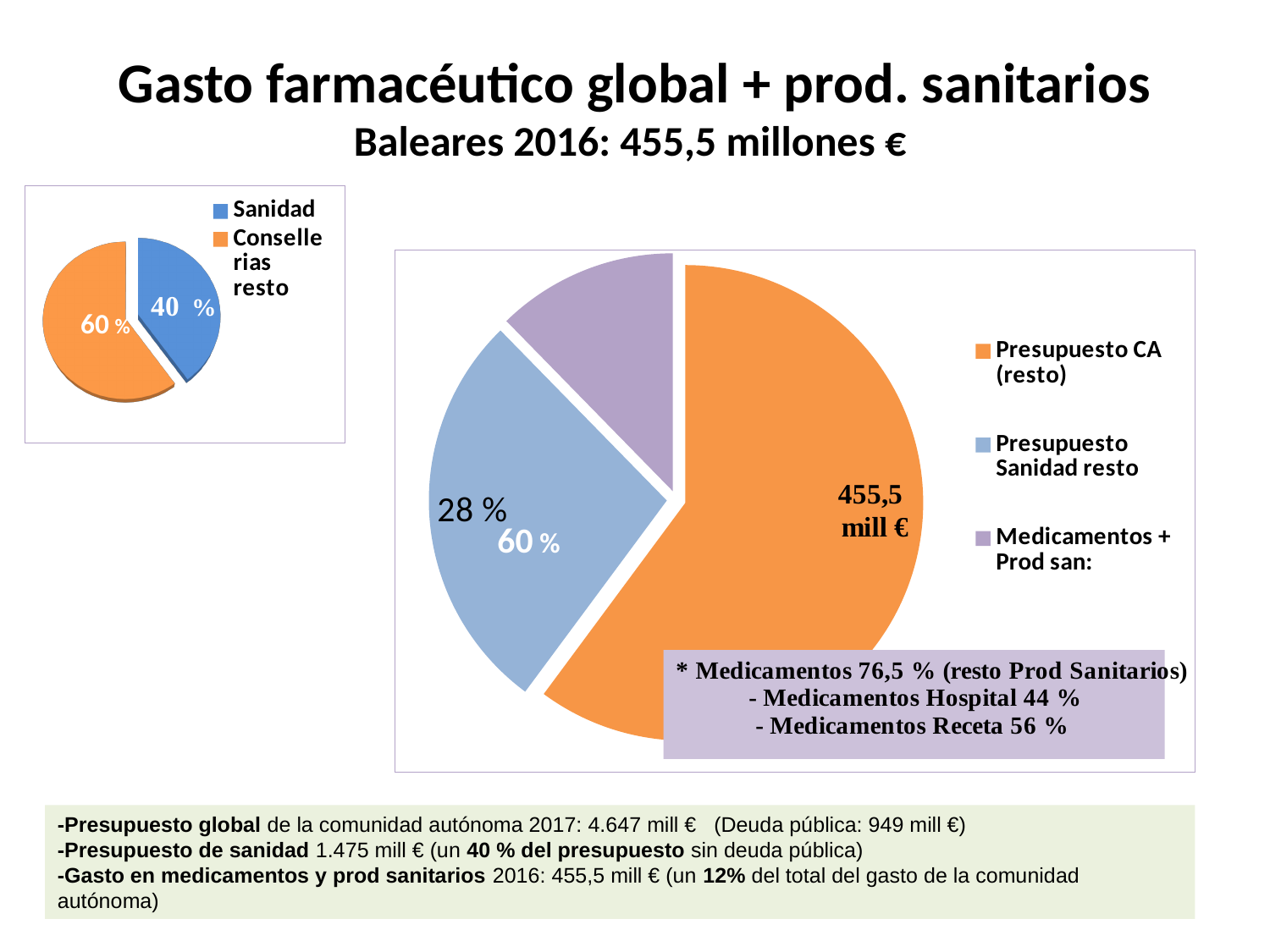
In the large pie chart on the right, what is the difference in percentage points between Presupuesto CA (resto) and Presupuesto Sanidad resto? 32 In the large pie chart on the right, what percentage is shown for Presupuesto Sanidad resto? 28 % In the small pie chart on the left, what percentage is shown for Consellerias resto? 60 % In the small pie chart on the left, what percentage is shown for Sanidad? 40 % In the large pie chart on the right, which colour represents Medicamentos + Prod san? Purple How many entries does the legend of the small pie chart on the left list? 2 In the large pie chart on the right, what percentage is shown for Presupuesto CA (resto)? 60 % In the large pie chart on the right, which category has the smallest slice? Medicamentos + Prod san In the large pie chart on the right, which category has the largest slice? Presupuesto CA (resto) What kind of chart is the large chart on the right? Pie chart In the small pie chart on the left, which category has the larger slice? Consellerias resto In the large pie chart on the right, how many slices does the pie have? 3